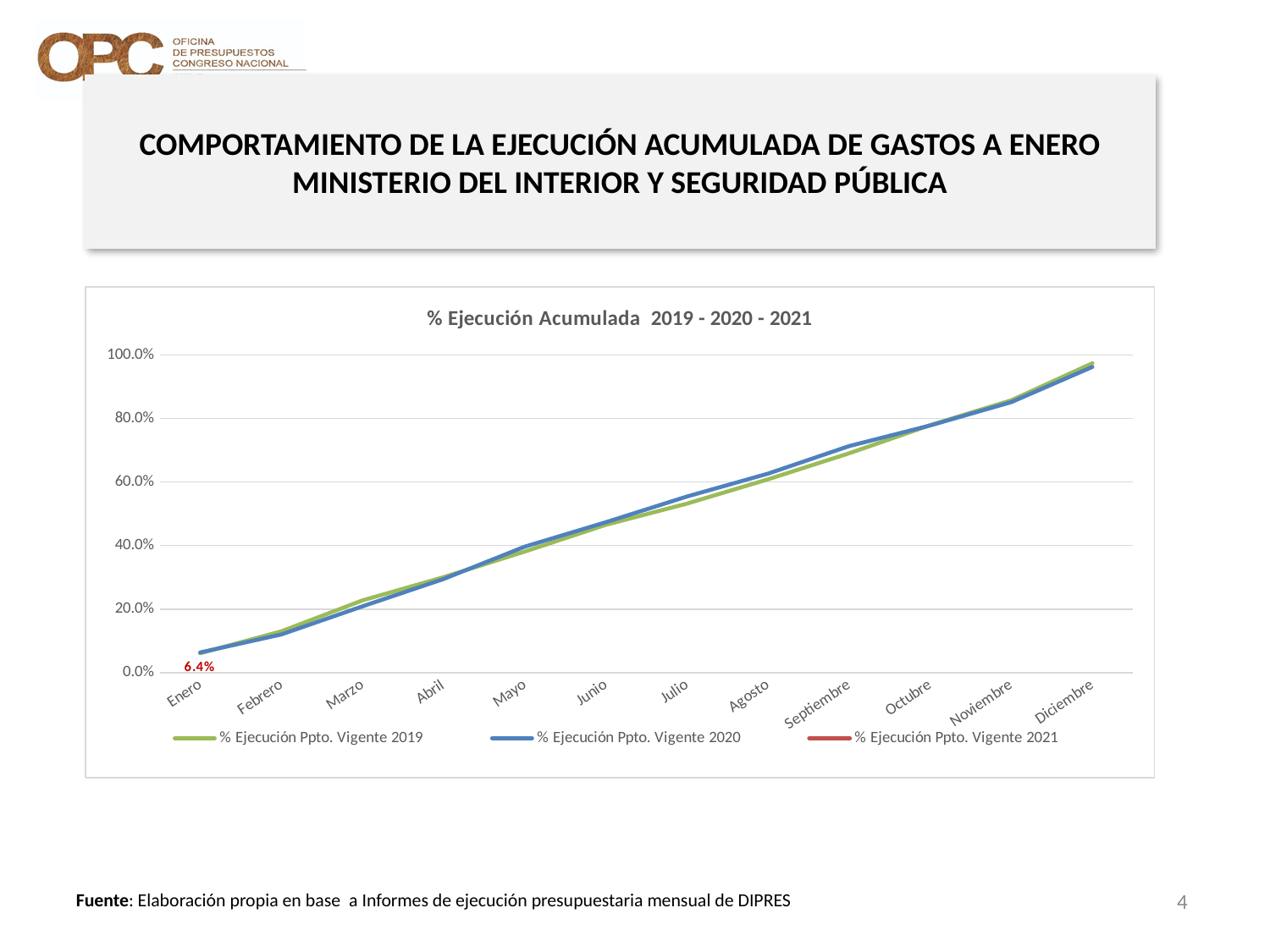
How many months are shown along the x axis of the chart? 12 For % Ejecución Ppto. Vigente 2020, which is larger: the value in Enero or the value in Diciembre? Diciembre What is the value labelled for % Ejecución Ppto. Vigente 2021 in Enero? 6.4% What is the title of the chart? % Ejecución Acumulada 2019 - 2020 - 2021 What kind of chart is shown on the slide? line chart Is the value for % Ejecución Ppto. Vigente 2019 in Marzo greater or less than 40.0%? less Is the value for % Ejecución Ppto. Vigente 2020 in Septiembre greater or less than 60.0%? greater Is the value for % Ejecución Ppto. Vigente 2020 in Diciembre greater or less than 80.0%? greater Do the values for % Ejecución Ppto. Vigente 2020 rise or fall from Enero to Diciembre? rise In which month does % Ejecución Ppto. Vigente 2019 reach its highest value? Diciembre In which month is % Ejecución Ppto. Vigente 2020 at its lowest value? Enero How many series does the chart legend list? 3